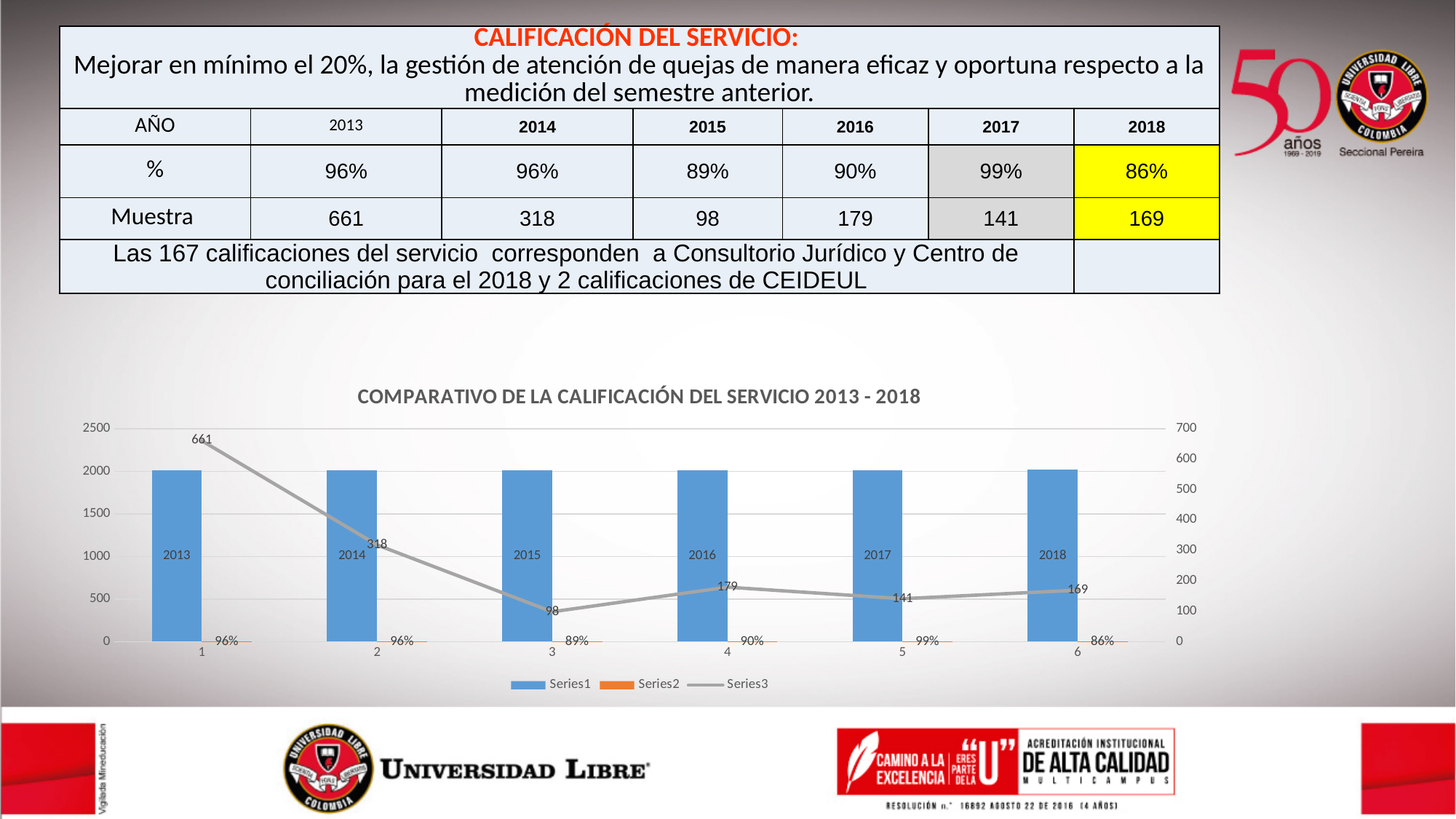
What is the title of the chart? COMPARATIVO DE LA CALIFICACIÓN DEL SERVICIO 2013 - 2018 How many bars are plotted in the chart? 6 How many series does the chart legend list? 3 What value does the Series3 line show at category 1 (the 2013 bar)? 661 Does the Series3 line generally rise or fall from category 1 to category 3? Fall At which category does the Series3 line reach its lowest value? 3 (2015) What value does the Series3 line show at category 6 (the 2018 bar)? 169 What value does the Series3 line show at category 3 (the 2015 bar)? 98 Which is larger, the Series3 value at category 4 (2016) or at category 5 (2017)? Category 4 (2016), 179 At which category does the Series3 line reach its highest value? 1 (2013) What percentage label is shown at category 5 (the 2017 bar)? 99% What is the difference between the Series3 values at category 1 (661) and category 2 (318)? 343